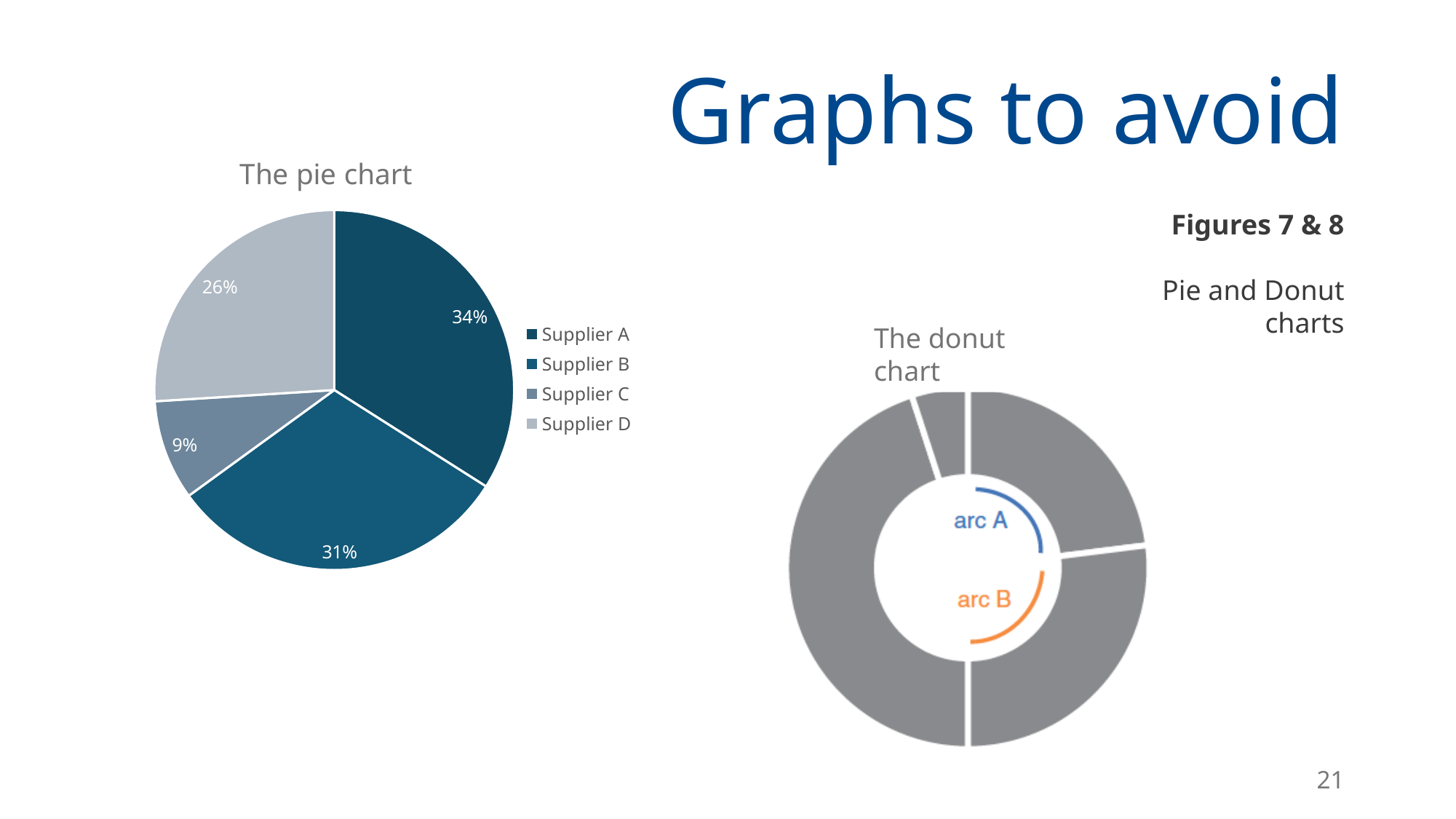
In the pie chart titled "The pie chart", what is the difference in percentage points between Supplier A and Supplier C? 25 In the pie chart titled "The pie chart", how many entries does the legend list? 4 In the pie chart titled "The pie chart", which supplier has the largest slice? Supplier A In the pie chart titled "The pie chart", which supplier has the smallest slice? Supplier C In the pie chart titled "The pie chart", what share does Supplier D have? 26% In the pie chart titled "The pie chart", how many suppliers are shown? 4 In the pie chart titled "The pie chart", what share does Supplier C have? 9% What kind of chart is the chart on the left of the slide titled "The pie chart"? Pie chart In the pie chart titled "The pie chart", what share does Supplier A have? 34% What is the title of the chart on the right of the slide? The donut chart In the pie chart titled "The pie chart", which is larger, Supplier D or Supplier C? Supplier D In the pie chart titled "The pie chart", what share does Supplier B have? 31%